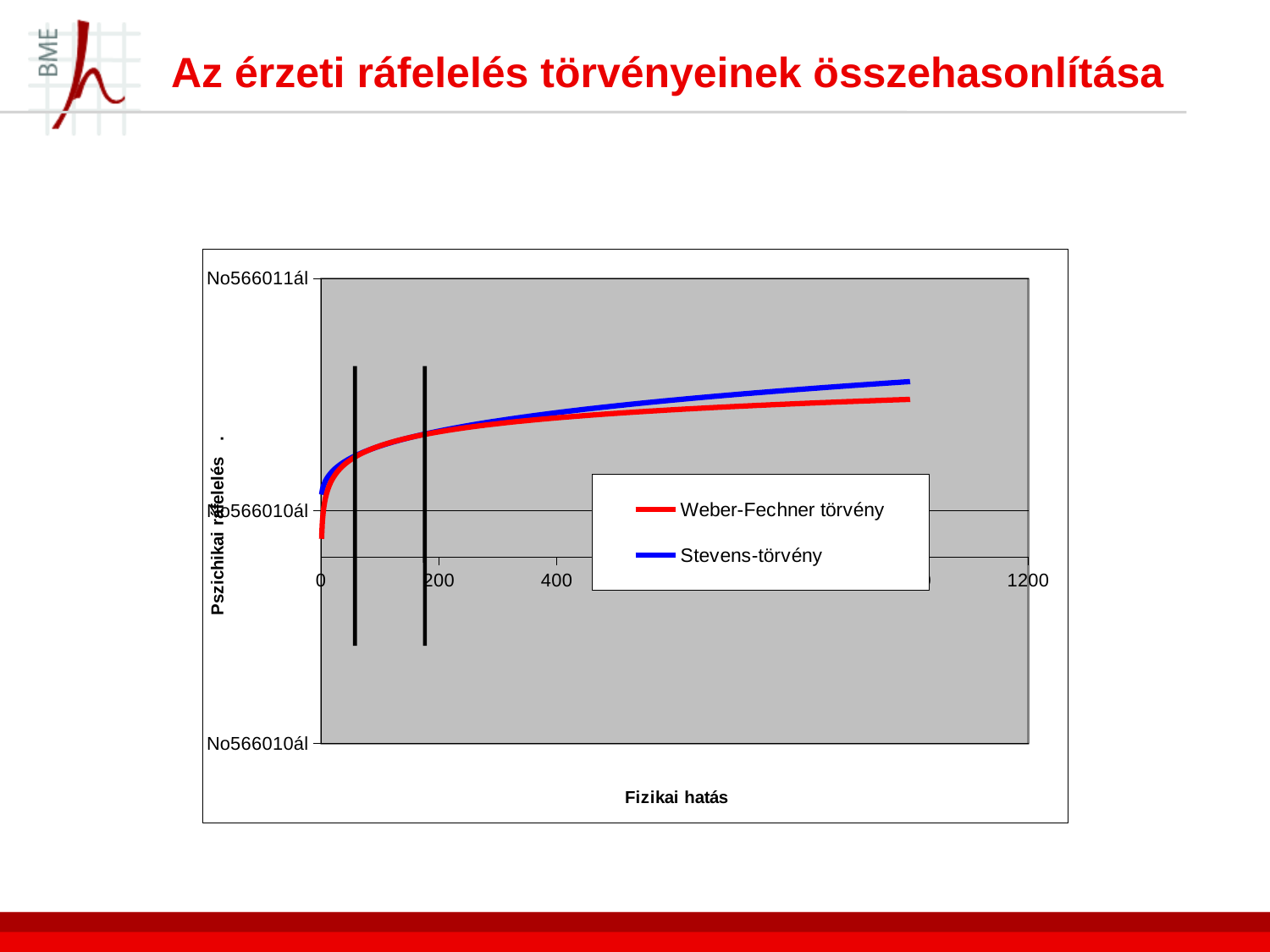
What kind of chart is shown on the slide? line chart At the right end of the chart (around 1000 on the x axis), which series has the higher value, Weber-Fechner törvény or Stevens-törvény? Stevens-törvény What are the two series named in the legend? Weber-Fechner törvény and Stevens-törvény Do the values of the Weber-Fechner törvény line rise or fall as Fizikai hatás increases? rise What is the largest tick value shown on the x axis? 1200 How many series does the legend list? 2 What is the title of the slide? Az érzeti ráfelelés törvényeinek összehasonlítása What is the title of the x axis? Fizikai hatás Do the values of the Stevens-törvény line rise or fall along the x axis? rise What colour is the line for Stevens-törvény? blue